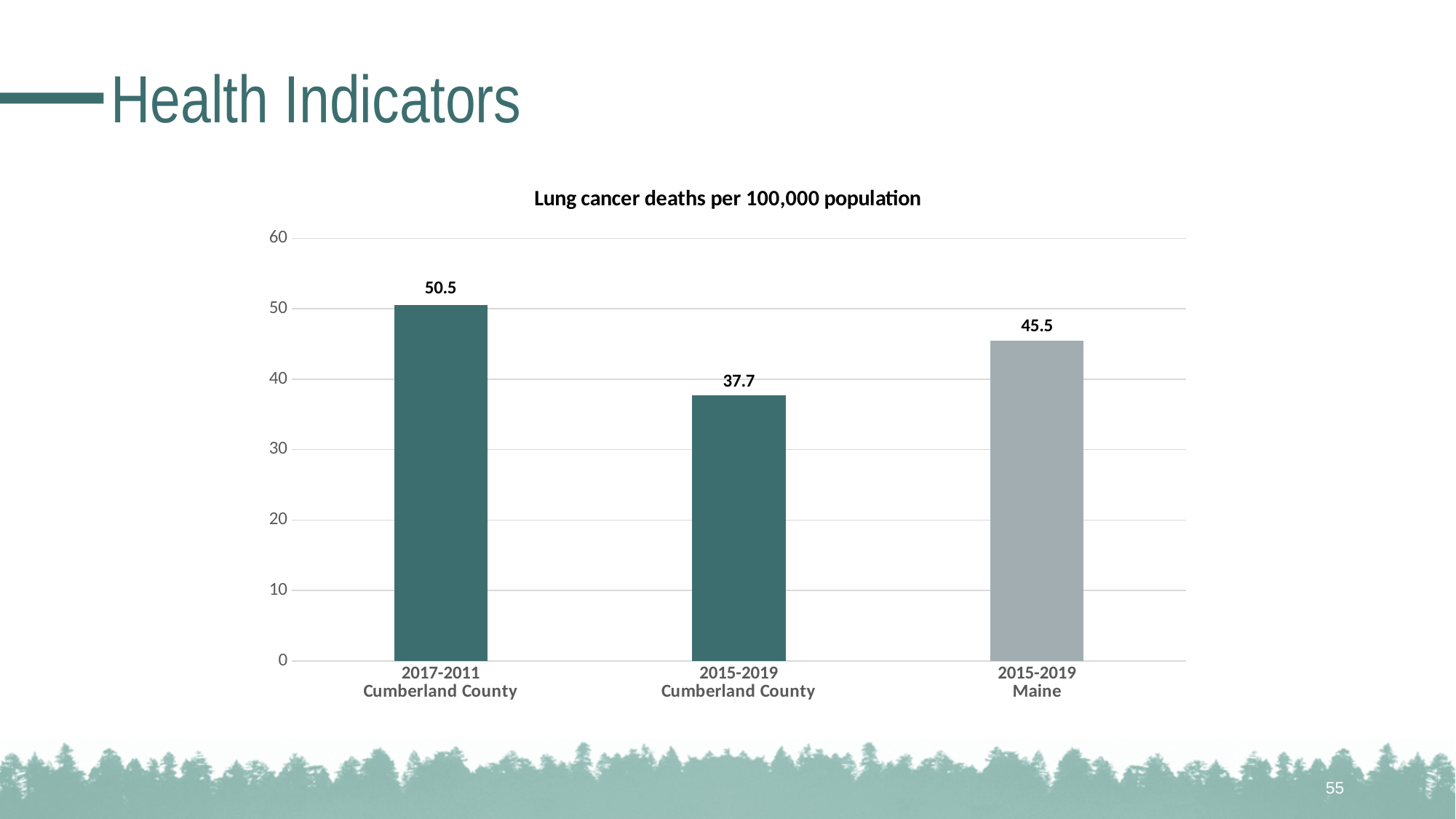
Which category has the highest value? 2017-2011 Cumberland County What is the value for 2015-2019 Maine? 45.5 What is the difference between the values for 2015-2019 Maine and 2015-2019 Cumberland County? 7.8 What kind of chart is shown on the slide? bar chart Which is larger, the value for 2015-2019 Maine or the value for 2015-2019 Cumberland County? 2015-2019 Maine How many bars are shown in the chart? 3 What is the difference between the values for 2017-2011 Cumberland County and 2015-2019 Cumberland County? 12.8 What is the title of the chart? Lung cancer deaths per 100,000 population Is the value for 2015-2019 Cumberland County greater or less than 40? less Which category has the lowest value? 2015-2019 Cumberland County What is the value for 2015-2019 Cumberland County? 37.7 What is the value for 2017-2011 Cumberland County? 50.5